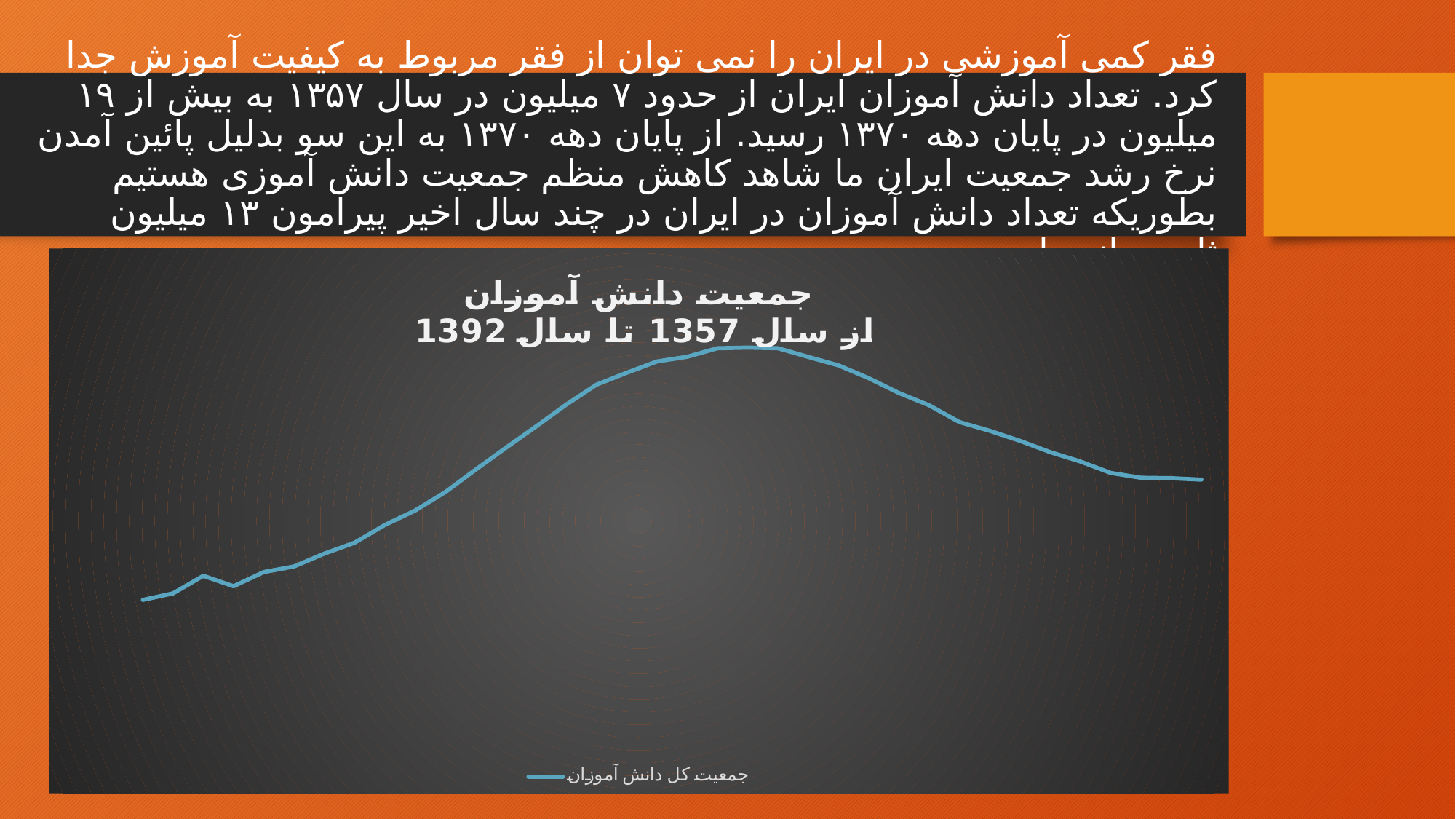
What is the title of the chart? جمعیت دانش آموزان از سال 1357 تا سال 1392 Where is the lowest point of the line: at the left end, in the middle, or at the right end? at the left end Is the highest point of the line at the left end, in the middle, or at the right end of the chart? in the middle Is the value at the right end of the line higher or lower than the value at the left end? higher How many series does the chart's legend list? 1 What is the legend entry for the plotted line? جمعیت کل دانش آموزان After reaching its peak, does the line rise or fall toward the right end of the chart? fall Is the value at the left end of the line higher or lower than the value at the peak? lower What kind of chart is shown on the slide? line chart Does the line rise or fall from its left end up to its peak? rise